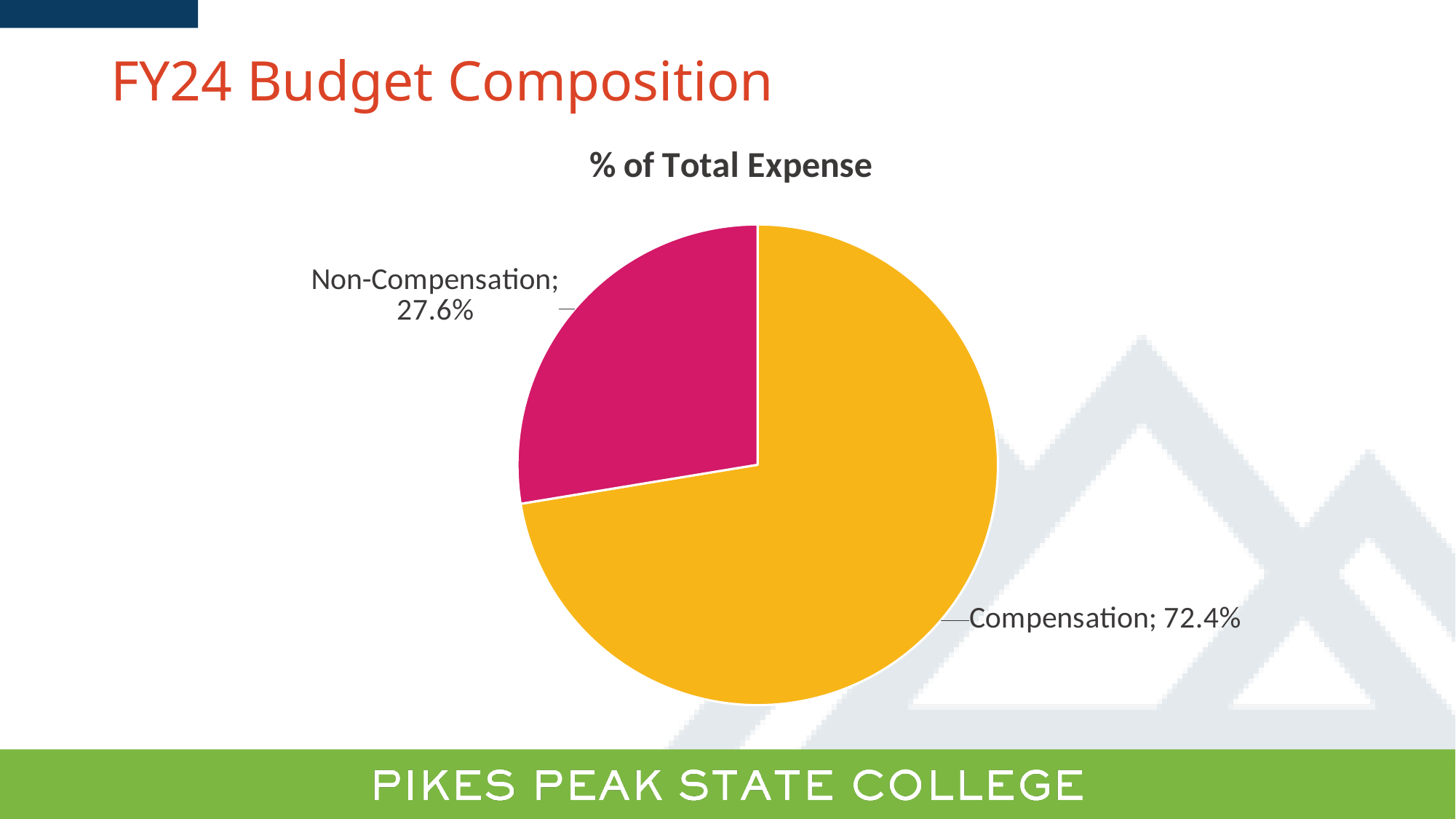
Which category has the smallest share of total expense? Non-Compensation Which category has the largest share of total expense? Compensation How many categories are shown in the pie chart? 2 What percentage of total expense is Compensation? 72.4% What kind of chart is shown on the slide? Pie chart What is the difference in percentage points between Compensation and Non-Compensation? 44.8 What colour is the Compensation slice? Yellow What is the combined share of Compensation and Non-Compensation? 100% What percentage of total expense is Non-Compensation? 27.6% What is the title of the chart? % of Total Expense Which is larger, Compensation or Non-Compensation? Compensation